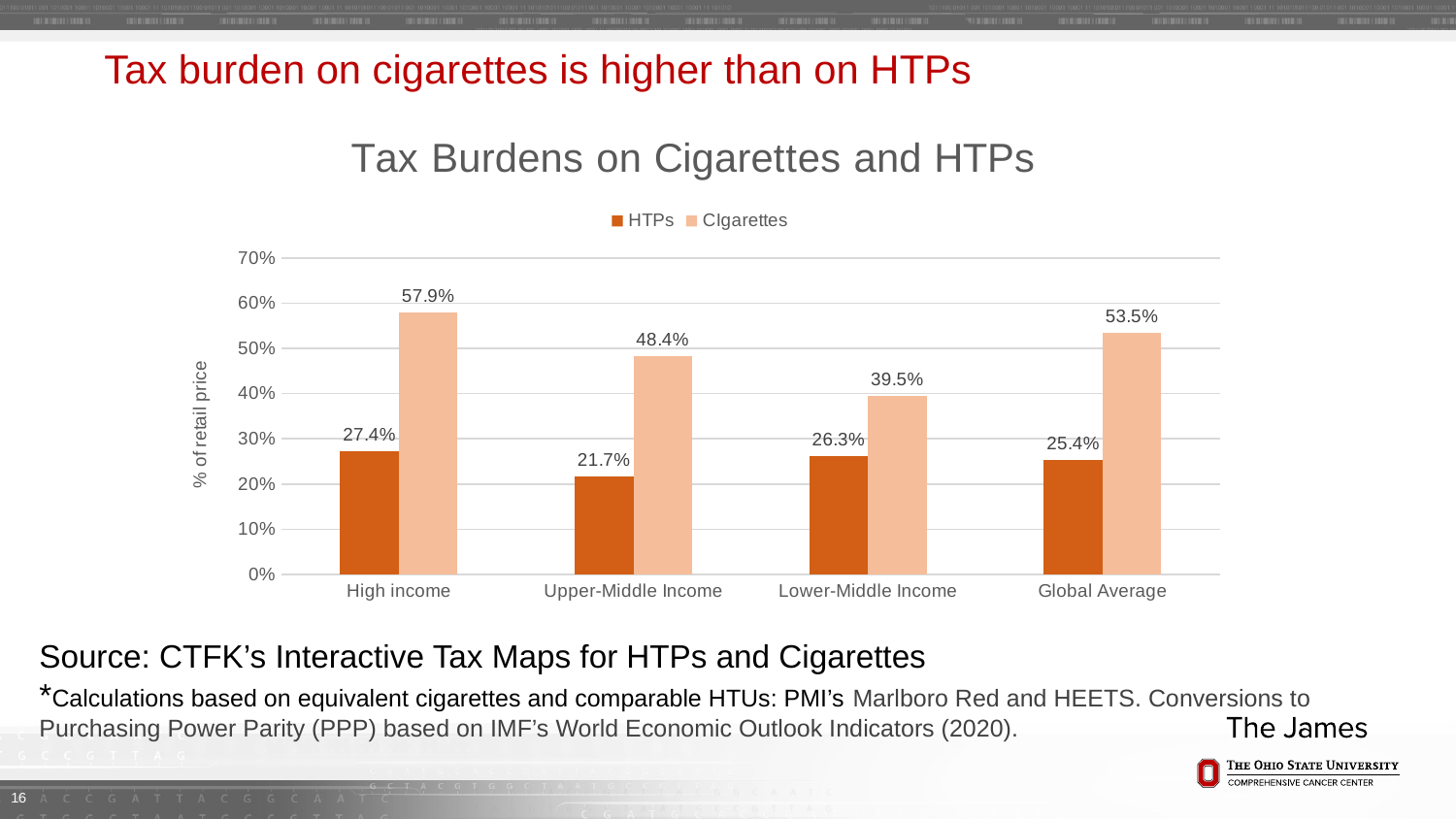
What is the tax burden on HTPs for Upper-Middle Income countries? 21.7% Which income group has the lowest tax burden on HTPs? Upper-Middle Income Which income group has the highest tax burden on cigarettes? High income What is the label of the y axis? % of retail price What type of chart is shown on the slide? Bar chart How many income categories are shown on the x axis? 4 What is the tax burden on cigarettes for High income countries? 57.9% What is the Global Average tax burden on cigarettes? 53.5% Which is larger for High income countries: the tax burden on HTPs or on cigarettes? Cigarettes How many series does the legend list? 2 What is the difference between the cigarette and HTP tax burdens for Lower-Middle Income countries? 13.2% Is the Global Average tax burden on HTPs greater or less than 30%? less